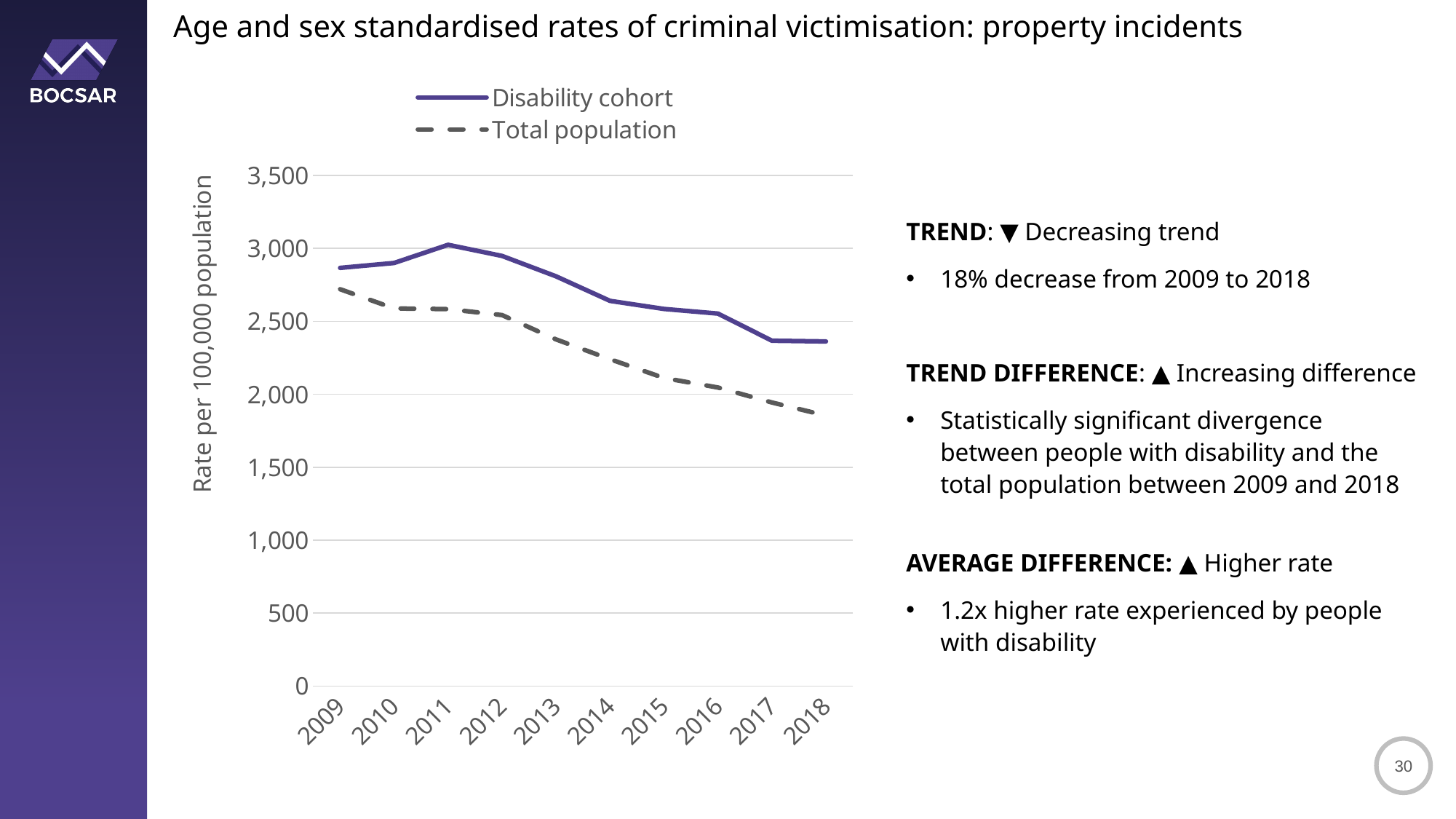
Does the Total population line rise or fall from 2009 to 2018? Fall How many series does the legend list? 2 In which year does the Total population line reach its lowest value? 2018 In which year does the Disability cohort line reach its highest value? 2011 Which series is drawn with a dashed line? Total population Is the value for the Disability cohort in 2009 greater or less than 2,500? greater Is the value for the Total population in 2018 greater or less than 2,000? less How many years are shown along the x axis? 10 What is the label on the y axis? Rate per 100,000 population What kind of chart is shown on the slide? Line chart In 2015, which series has the higher value, Disability cohort or Total population? Disability cohort Is the value for the Disability cohort in 2018 greater or less than 2,500? less